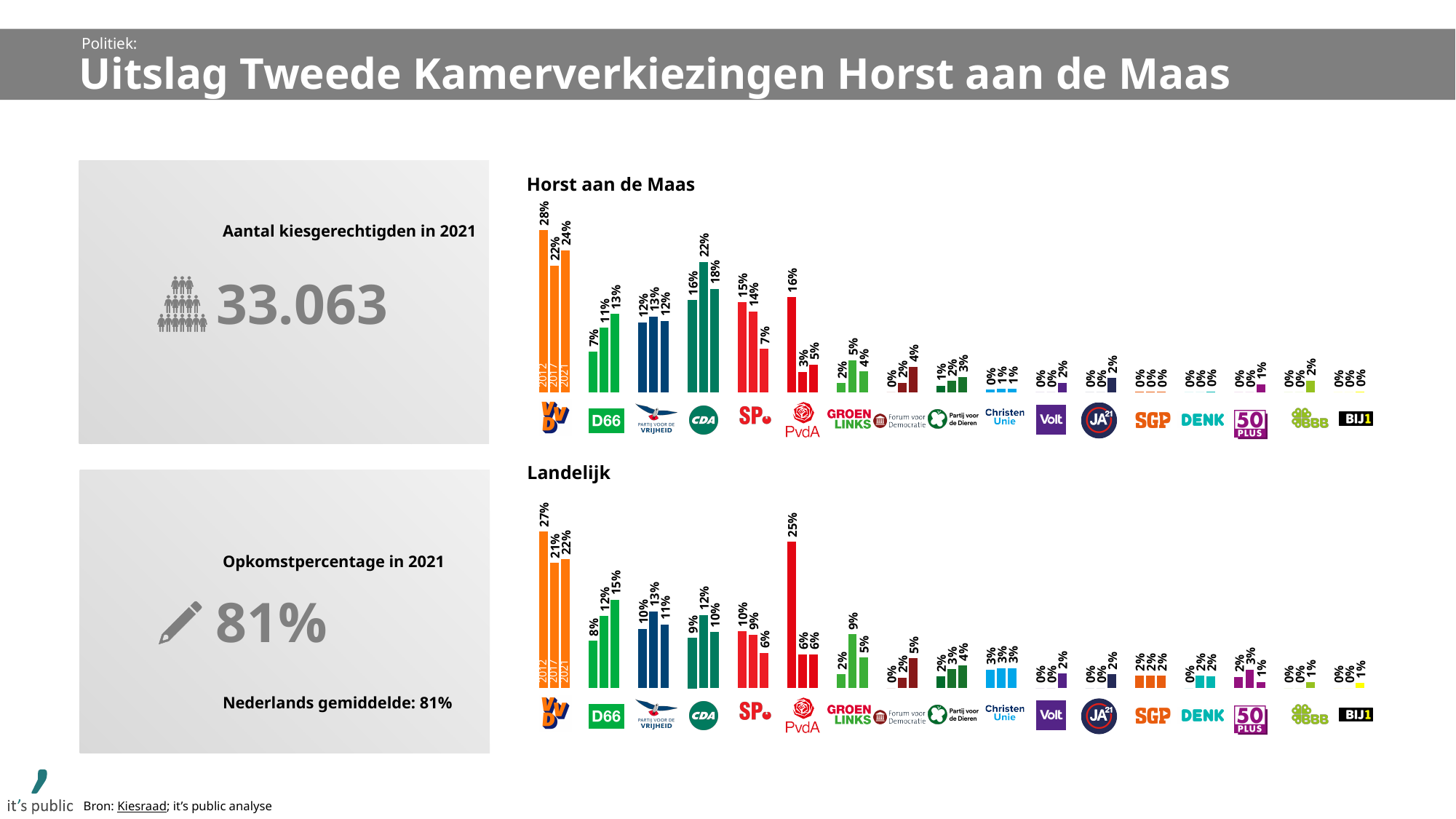
In the 'Horst aan de Maas' chart, did D66's share rise or fall from 2012 to 2021? Rise In the 'Horst aan de Maas' chart, which party had the highest share in 2021? VVD In the 'Horst aan de Maas' chart, what is the difference between the SP's share in 2012 and in 2021? 8% In the 'Landelijk' chart, which party had the highest share in 2012? VVD What type of chart is the 'Landelijk' chart? Bar chart In the 'Landelijk' chart, what is the difference between the PvdA's share in 2012 and in 2017? 19% In the 'Landelijk' chart, what was D66's share in 2021? 15% How many years (series) are shown for each party in the 'Landelijk' chart? 3 In the 'Horst aan de Maas' chart, which was larger in 2021: the CDA's share or the PVV's share? CDA In the 'Horst aan de Maas' chart, what was the CDA's share in 2017? 22% In the 'Landelijk' chart, what was the PvdA's share in 2012? 25% In the 'Horst aan de Maas' chart, what was the VVD's share in 2021? 24%